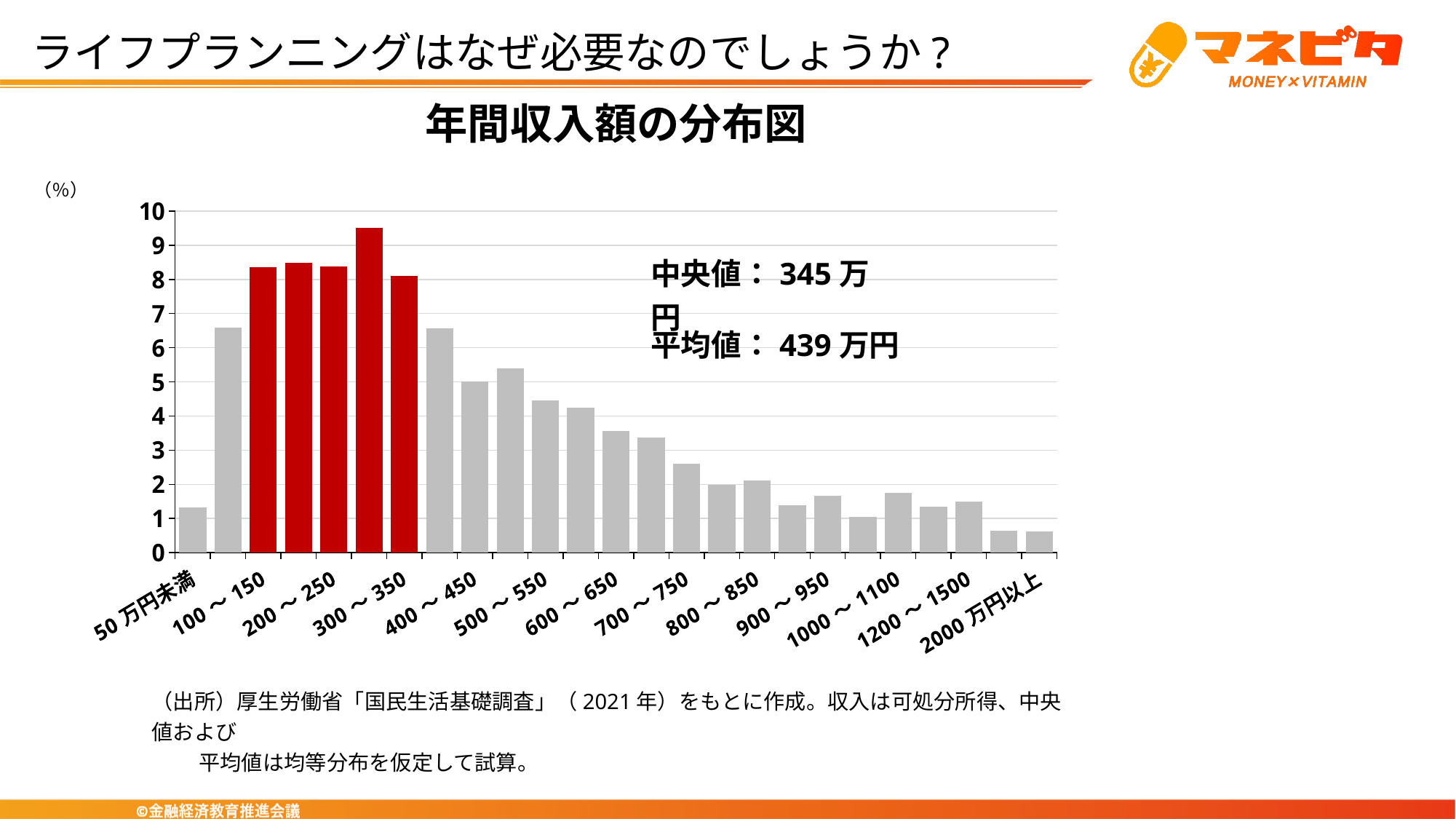
What is the title of the chart? 年間収入額の分布図 Is the value for 2000万円以上 greater or less than 1? less Which is larger, the value for 100～150 or the value for 400～450? 100～150 Is the value for 700～750 greater or less than 4? less Which is larger, the value for 600～650 or the value for 800～850? 600～650 Is the value for 50万円未満 greater or less than 2? less What median value (中央値) is stated on the chart? 345万円 Do the values generally rise or fall from 400～450 to 2000万円以上? fall What type of chart is shown on the slide? Bar chart